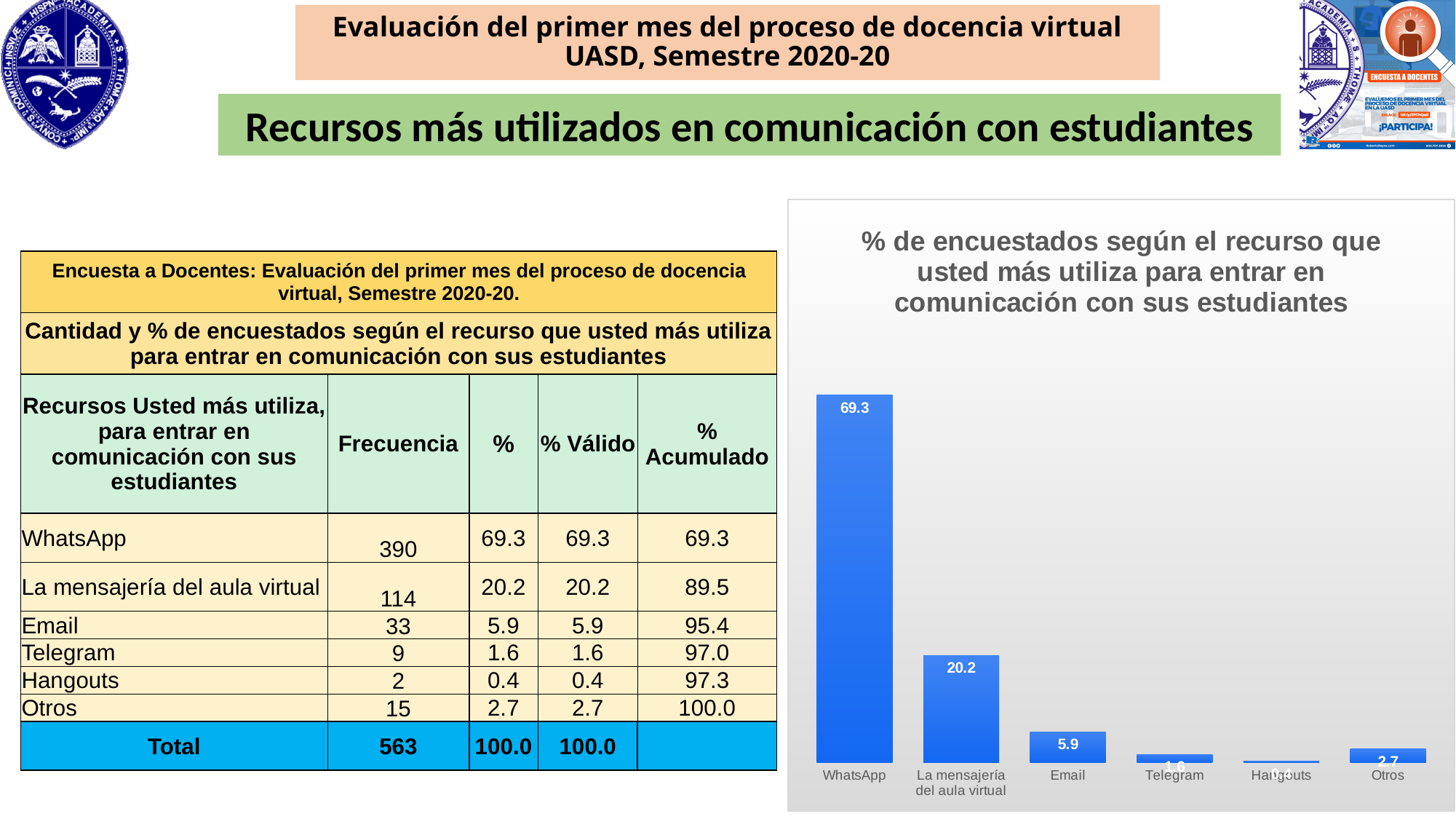
What is the value for La mensajería del aula virtual in the bar chart? 20.2 What type of chart is shown on the slide? bar chart What is the value for Otros in the bar chart? 2.7 What is the value for Telegram in the bar chart? 1.6 What is the value for WhatsApp in the bar chart? 69.3 Which category has the highest value in the bar chart? WhatsApp How many categories are shown in the bar chart? 6 What is the value for Email in the bar chart? 5.9 Which category has the lowest value in the bar chart? Hangouts What is the difference between the values for WhatsApp and La mensajería del aula virtual in the bar chart? 49.1 What is the title of the bar chart? % de encuestados según el recurso que usted más utiliza para entrar en comunicación con sus estudiantes Which has a larger value in the bar chart, Email or Otros? Email